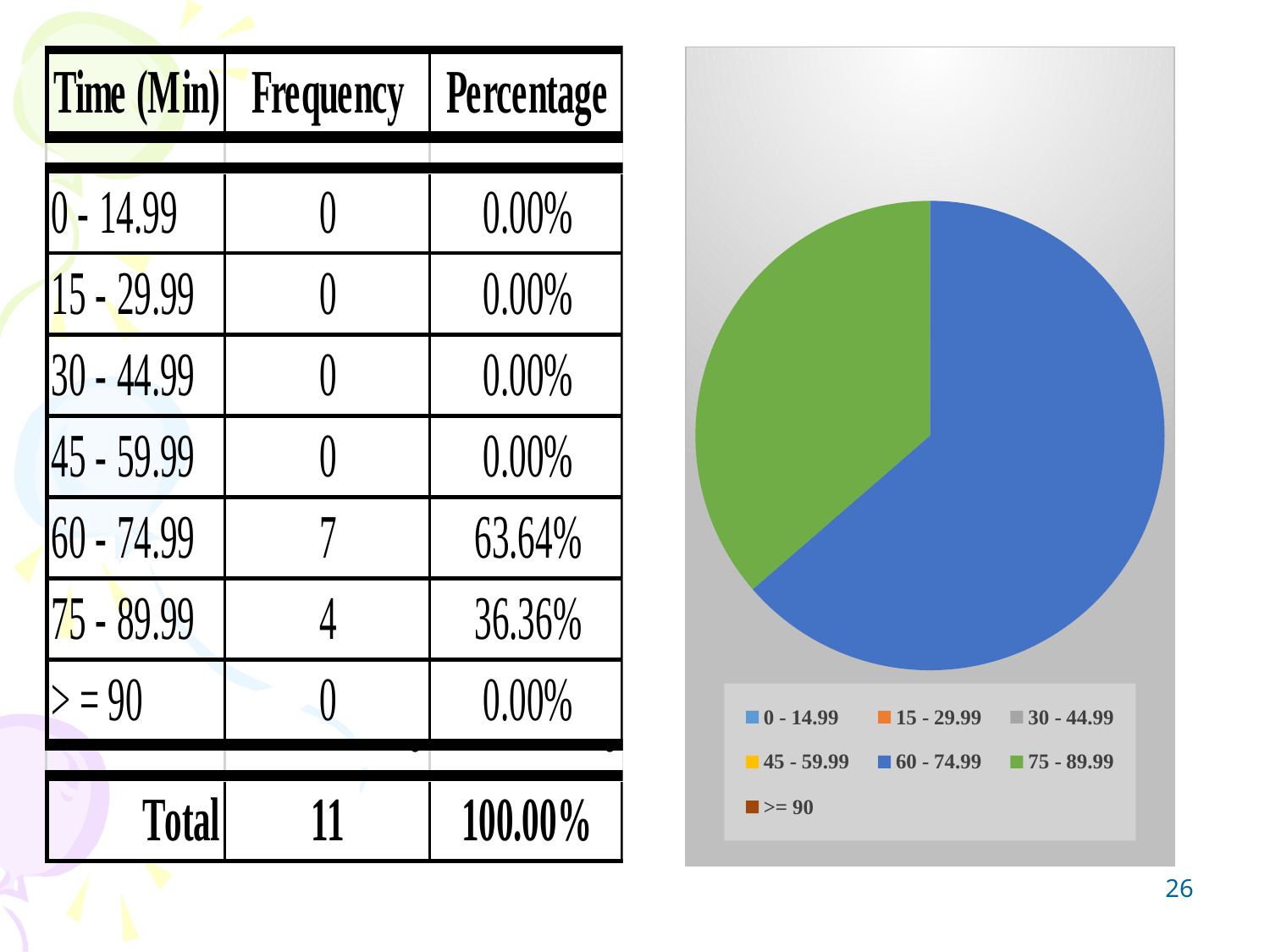
What is the total frequency across all time categories? 11 Which slice is larger in the pie chart, 60 - 74.99 or 75 - 89.99? 60 - 74.99 What kind of chart is shown on the right side of the slide? pie chart What colour is the 75 - 89.99 slice in the pie chart? green What share of the pie does the 60 - 74.99 category represent? 63.64% What is the difference in percentage between the 60 - 74.99 and 75 - 89.99 categories? 27.28% What share of the pie does the 75 - 89.99 category represent? 36.36% Is the share of the pie for 60 - 74.99 greater or less than 50%? greater Which time category has the largest slice in the pie chart? 60 - 74.99 How many categories does the pie chart's legend list? 7 What is the difference in frequency between the 60 - 74.99 and 75 - 89.99 categories? 3 What is the frequency for the 60 - 74.99 category? 7